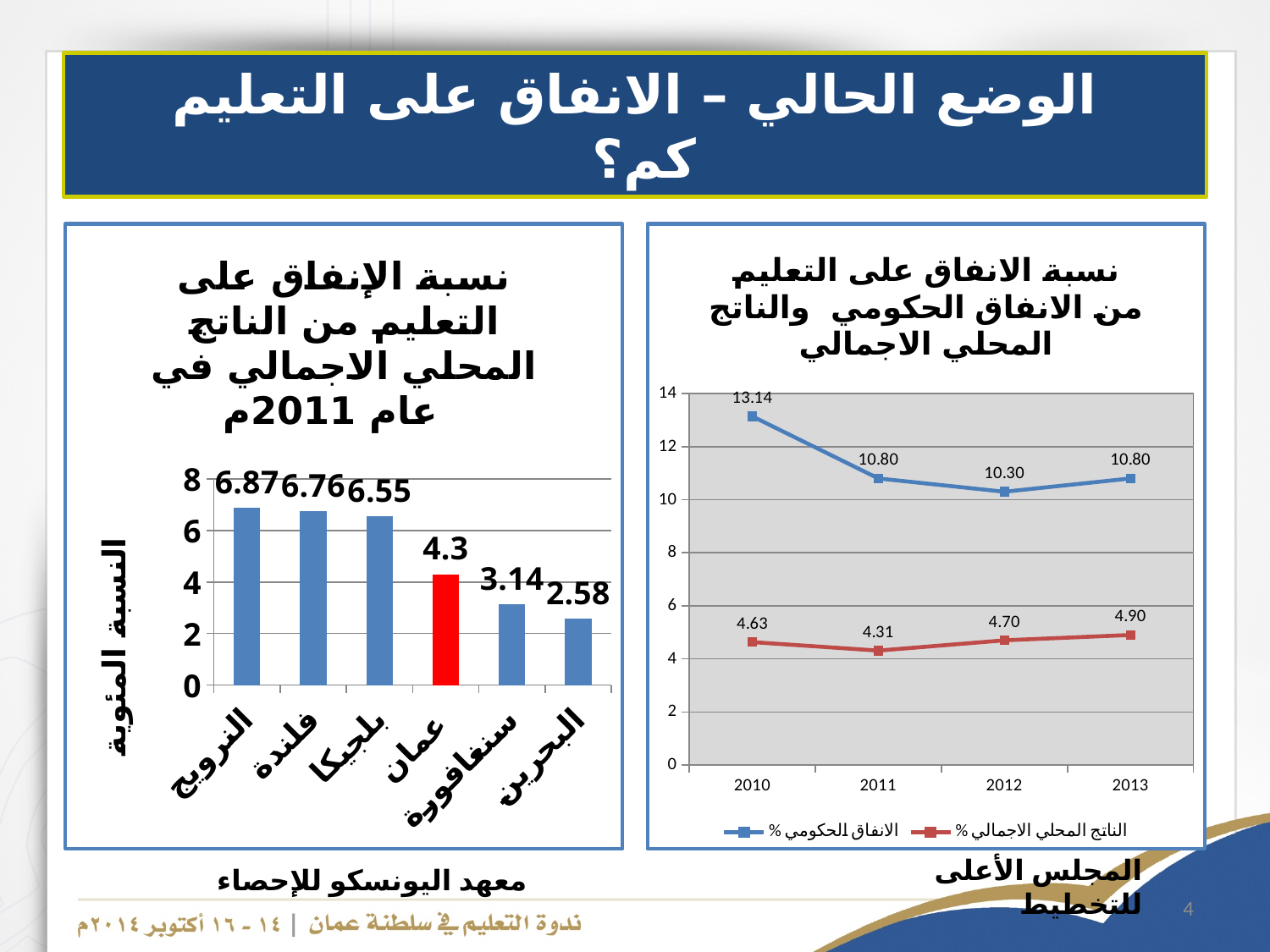
In the left chart (education spending as % of GDP in 2011), how many countries are shown? 6 In the right chart, what is the value of الناتج المحلي الاجمالي % in 2013? 4.90 In the left chart (education spending as % of GDP in 2011), which bar is coloured red rather than blue? عمان In the left chart (education spending as % of GDP in 2011), what is the difference between the values for النرويج and عمان? 2.57 In the left chart (education spending as % of GDP in 2011), which country has the lowest value? البحرين In the left chart (education spending as % of GDP in 2011), which country has the highest value? النرويج In the right chart, what is the difference between the الانفاق الحكومي % values for 2010 and 2011? 2.34 In the right chart, which is larger in 2012: الانفاق الحكومي % or الناتج المحلي الاجمالي %? الانفاق الحكومي % In the right chart, how many series does the legend list? 2 In the right chart, what is the value of الانفاق الحكومي % in 2010? 13.14 In the left chart (education spending as % of GDP in 2011), what is the value for عمان? 4.3 What type of chart is the left chart on the slide? Bar chart